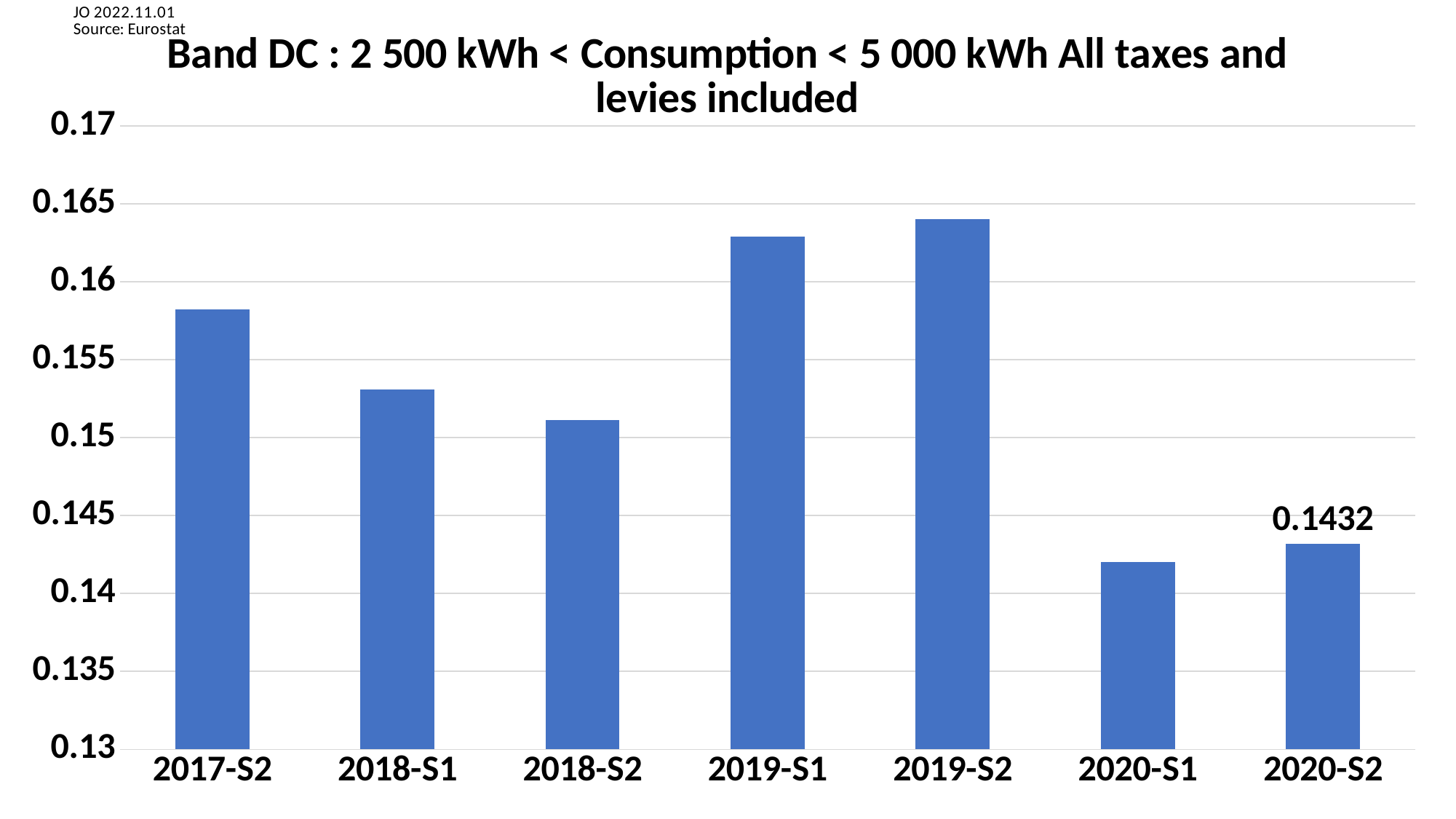
What is the value for 2020-S2? 0.1432 What type of chart is shown on the slide? bar chart Which period has the lowest value? 2020-S1 Which is larger, the value for 2019-S1 or the value for 2018-S2? 2019-S1 Is the value for 2019-S1 greater or less than 0.16? greater Do the values rise or fall from 2017-S2 to 2018-S2? fall Is the value for 2018-S2 greater or less than 0.155? less Which period has the highest value? 2019-S2 Is the value for 2020-S1 greater or less than 0.145? less How many periods (bars) are shown on the chart? 7 What is the title of the chart? Band DC : 2 500 kWh < Consumption < 5 000 kWh All taxes and levies included